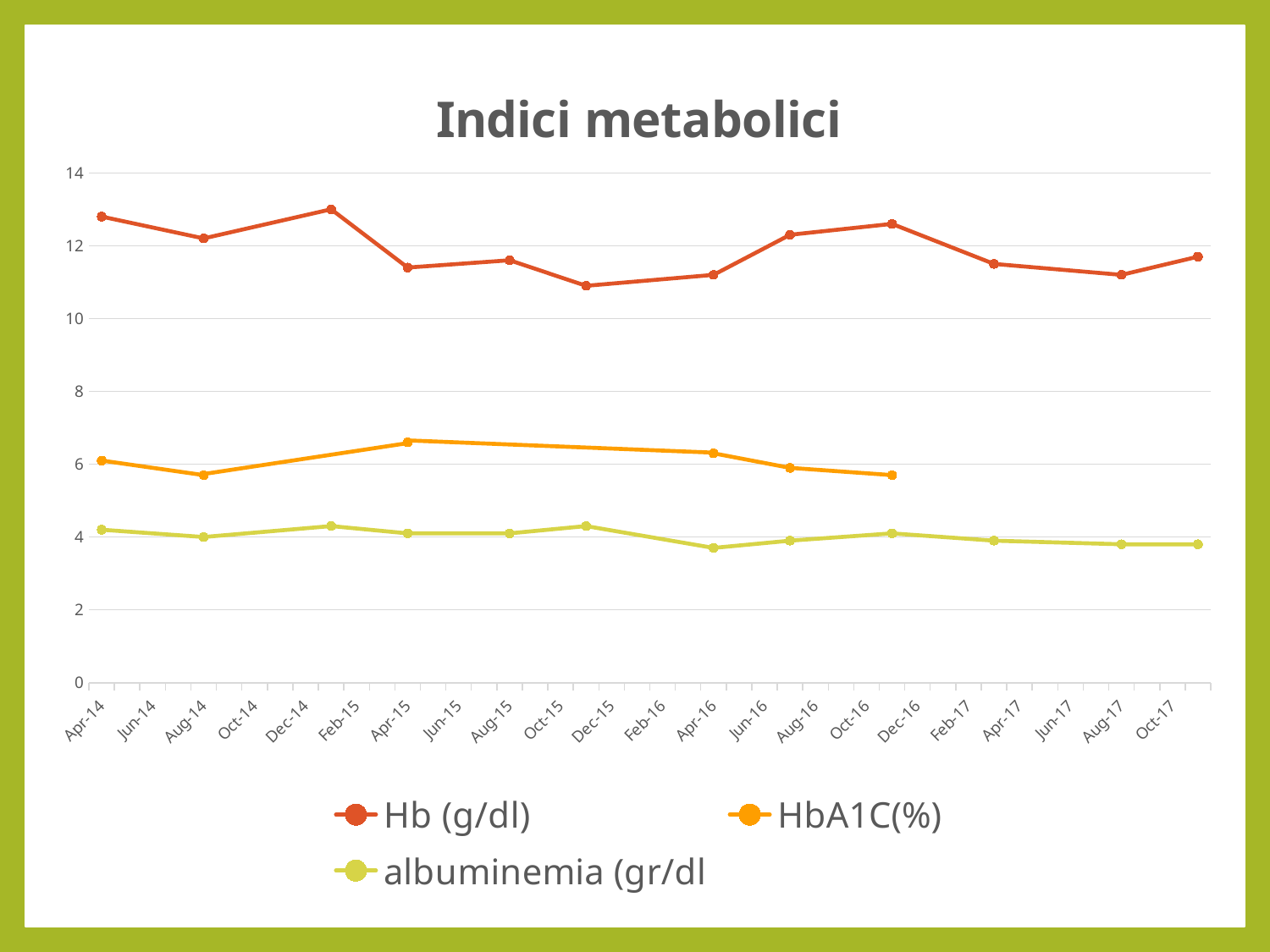
Which is larger: Hb (g/dl) at Apr-14 or Hb (g/dl) at Dec-15? Apr-14 What type of chart is shown on the slide? Line chart At which date does HbA1C(%) reach its highest value? Apr-15 How many series does the legend list? 3 Is the value of Hb (g/dl) at Apr-14 greater or less than 12? greater Which series is plotted with the highest values across the whole chart? Hb (g/dl) Is the value of Hb (g/dl) at Dec-15 greater or less than 12? less Is the value of HbA1C(%) at Apr-15 greater or less than 6? greater How many data points are plotted for the HbA1C(%) series? 6 Does the HbA1C(%) series rise or fall from Apr-15 to Dec-16? Fall What is the title of the chart? Indici metabolici